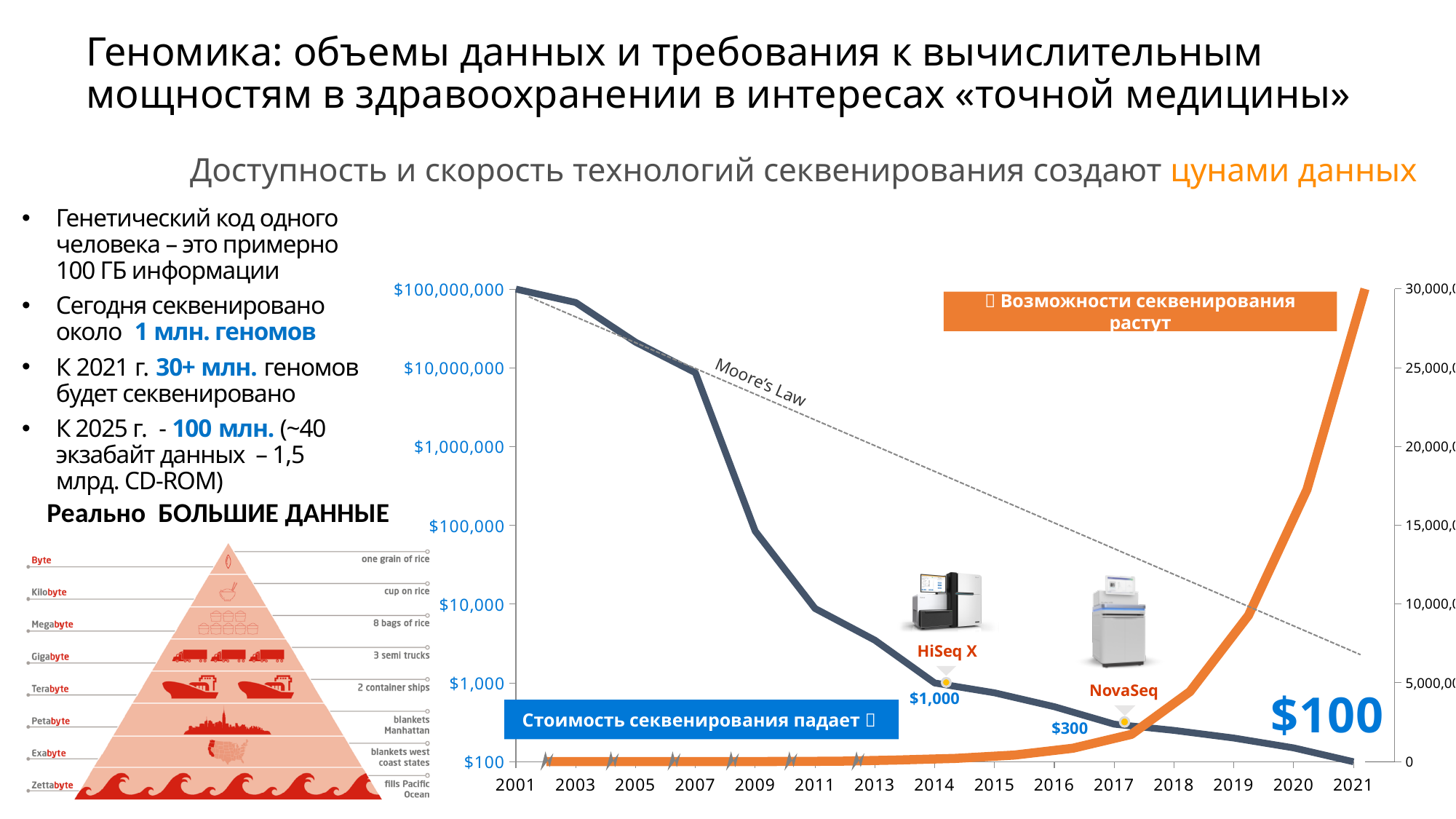
Which is larger: the labelled sequencing cost at HiSeq X or at NovaSeq? HiSeq X Is the sequencing cost in 2007 greater or less than $1,000,000? greater What sequencing cost is labelled at the NovaSeq point on the chart? $300 What is the difference between the labelled cost at HiSeq X and the labelled cost at NovaSeq? $700 What kind of chart is shown on the right side of the slide? line chart What sequencing cost is labelled at the end of the dark line in 2021? $100 Does the orange sequencing-capacity line rise or fall from 2001 to 2021? rise Is the sequencing cost in 2011 greater or less than $100,000? less What sequencing cost is labelled at the HiSeq X point on the chart? $1,000 What is the difference between the labelled cost at HiSeq X and the labelled cost in 2021? $900 What is the label on the dashed grey line in the chart? Moore's Law Does the dark sequencing-cost line rise or fall from 2001 to 2021? fall